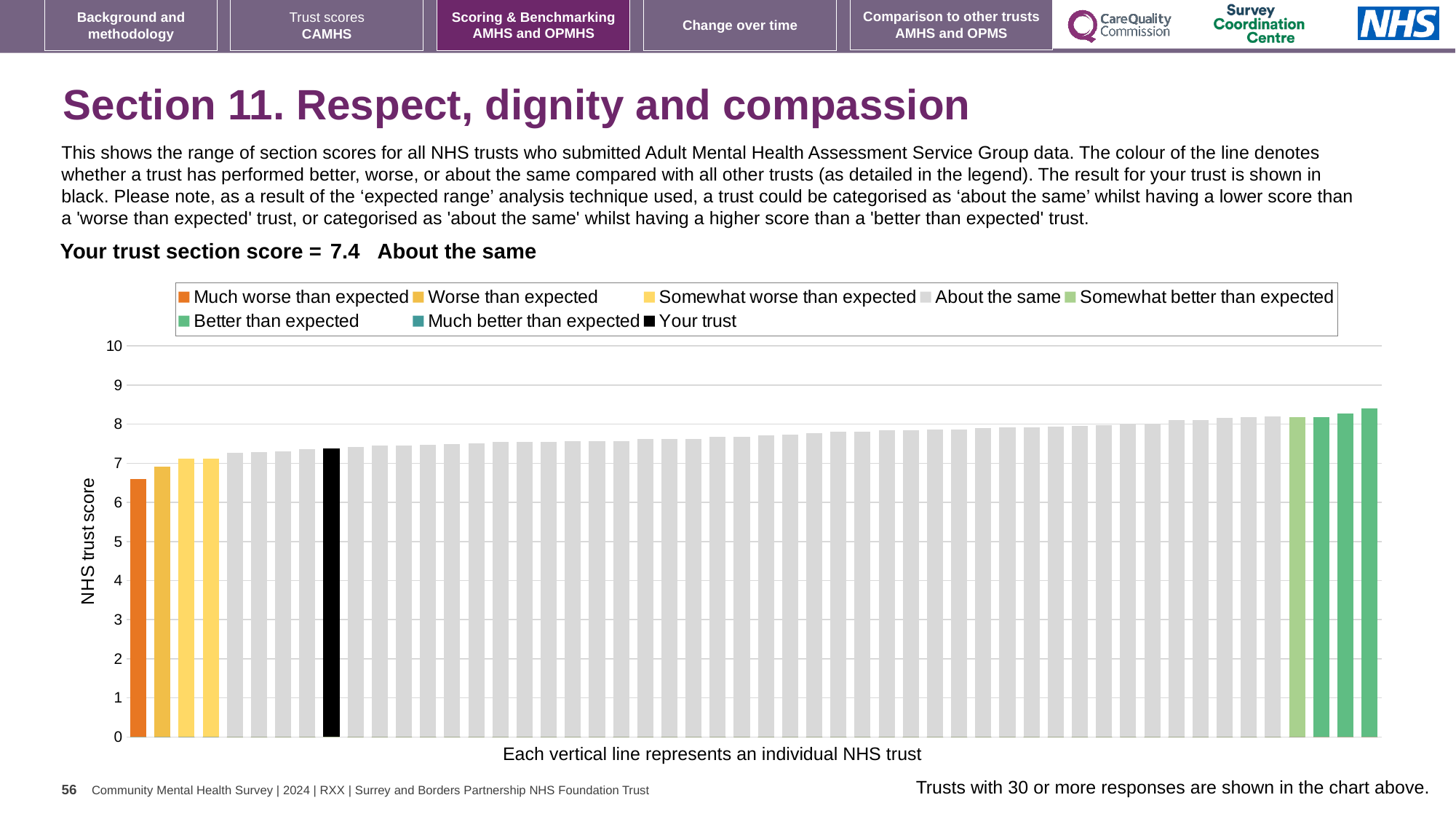
How many bars are coloured as 'Better than expected'? 3 What is the section score for your trust shown on the slide? 7.4 Which legend category does the lowest bar in the chart belong to? Much worse than expected Do the bar values rise or fall from left to right along the x axis? rise Is the value of the lowest bar in the chart greater or less than 7? less Which is larger: the value for your trust or the value of the orange 'Much worse than expected' bar? your trust What kind of chart is shown on the slide? bar chart How many entries does the chart legend list? 8 How many bars are coloured as 'Much worse than expected'? 1 What is the label on the vertical axis of the chart? NHS trust score Is the value for your trust (the black bar) greater or less than 7? greater Is the value of the highest bar in the chart greater or less than 8? greater